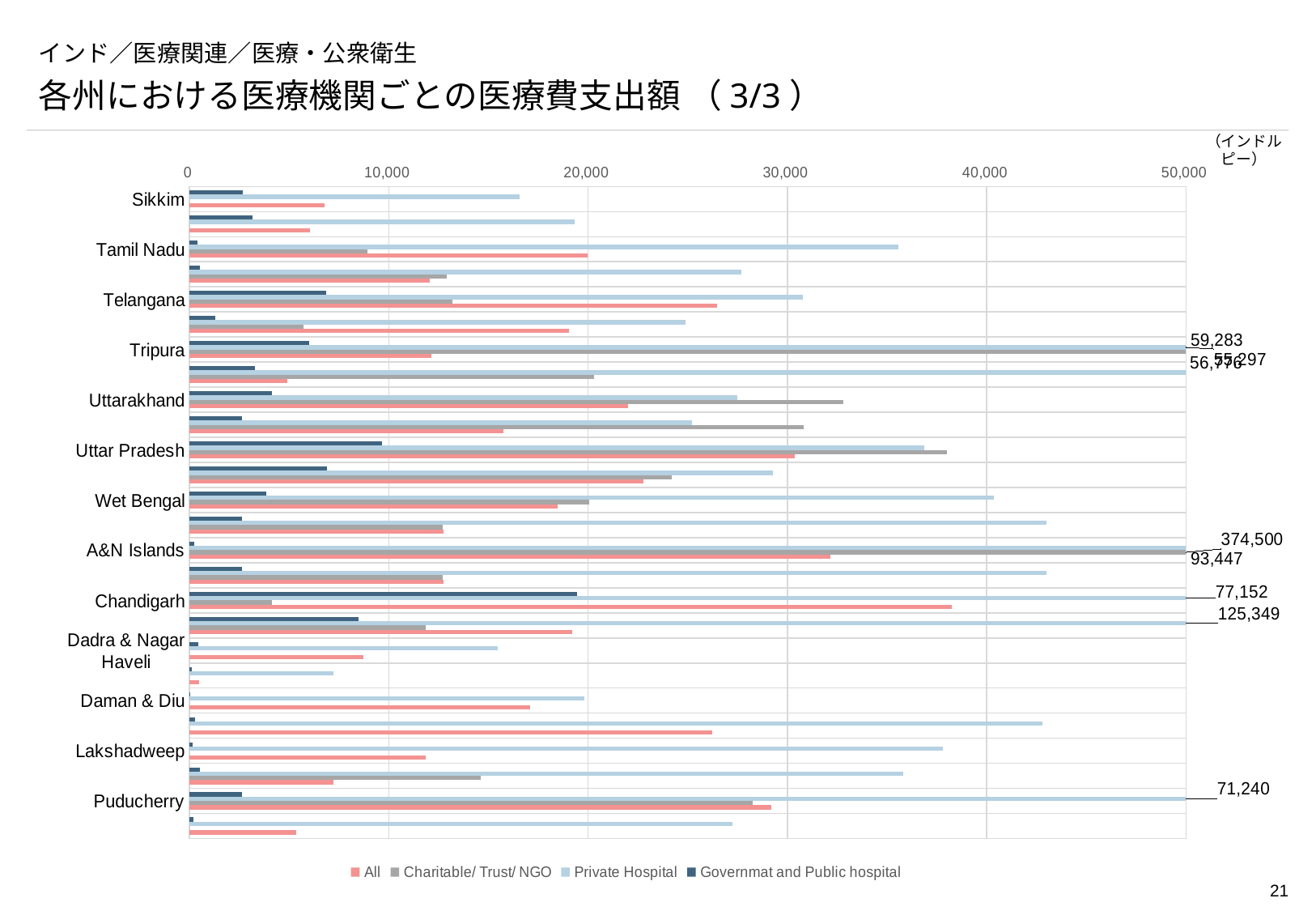
How many states or territories are listed on the vertical axis of the chart? 13 Is the longest Private Hospital bar for Lakshadweep greater or less than 30,000? greater Which is larger: the labelled value for Puducherry (71,240) or the smaller labelled value for Chandigarh (77,152)? Chandigarh (77,152) What unit is indicated at the top right of the chart? インドルピー What is the difference between the two labelled values for Chandigarh, 125,349 and 77,152? 48,197 What are the two data labels printed for Chandigarh? 77,152 and 125,349 What is the largest data label printed on the chart? 374,500 Which state or territory has the bar labelled 374,500? A&N Islands How many series does the legend list? 4 What kind of chart is shown on the slide? bar chart What data label is printed next to the Puducherry bar that extends beyond the axis? 71,240 Is the longest bar for Sikkim greater or less than 10,000? greater